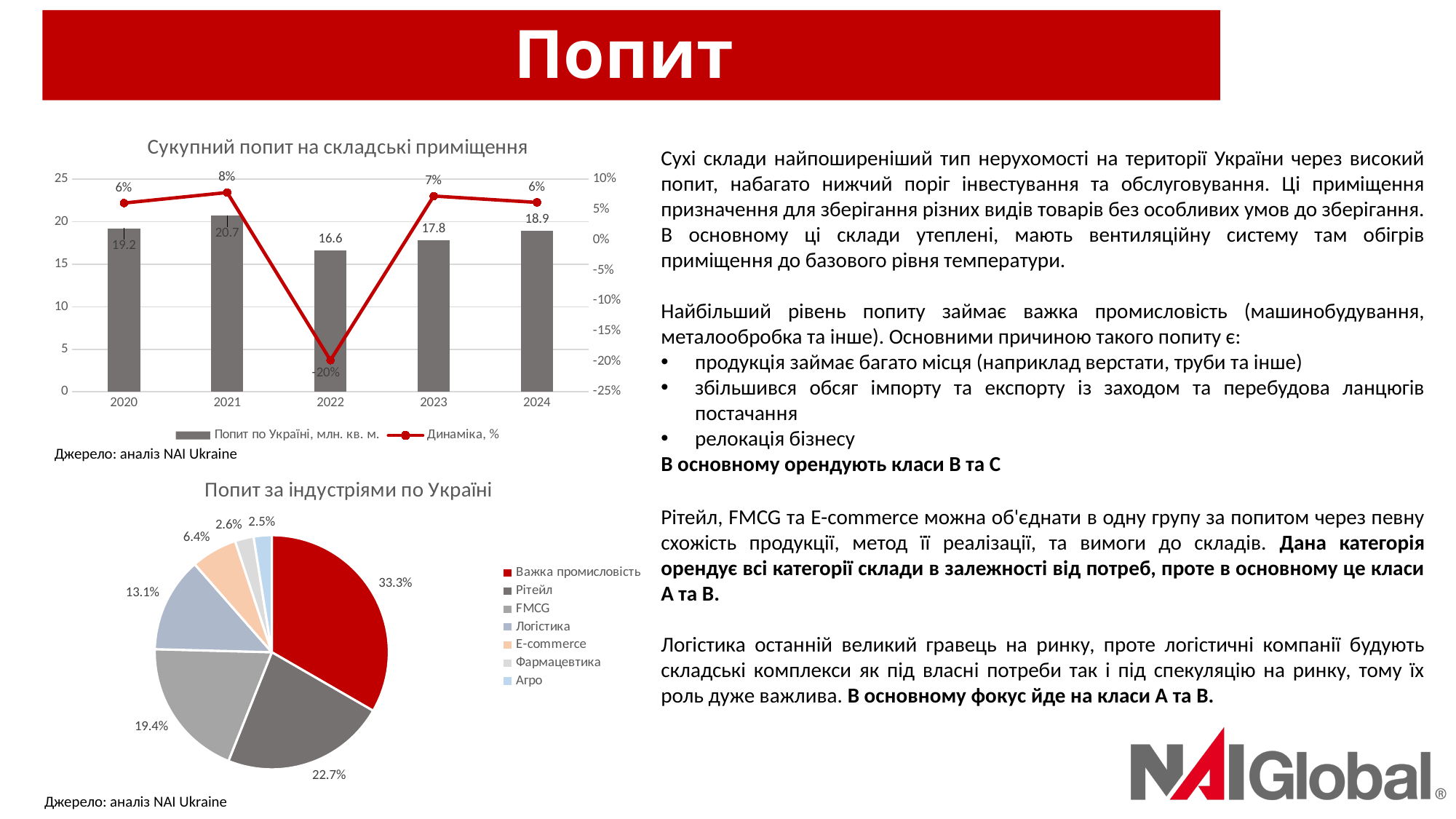
In the chart 'Сукупний попит на складські приміщення', what is the difference between the demand values for 2024 and 2023? 1.1 In the chart 'Сукупний попит на складські приміщення', how many series does the legend list? 2 In the chart 'Сукупний попит на складські приміщення', what is the value of 'Попит по Україні, млн. кв. м.' for 2021? 20.7 In the chart 'Попит за індустріями по Україні', what share does 'Логістика' have? 13.1% In the chart 'Попит за індустріями по Україні', which industry has the largest slice? Важка промисловість In the chart 'Попит за індустріями по Україні', how many industries does the legend list? 7 In the chart 'Сукупний попит на складські приміщення', does the demand value rise or fall from 2022 to 2024? rise In the chart 'Сукупний попит на складські приміщення', which year has the highest demand bar? 2021 What type of chart is 'Попит за індустріями по Україні'? pie chart In the chart 'Сукупний попит на складські приміщення', which year has the lowest demand bar? 2022 In the chart 'Сукупний попит на складські приміщення', what is the 'Динаміка, %' value for 2022? -20% In the chart 'Сукупний попит на складські приміщення', how many years are shown on the x axis? 5